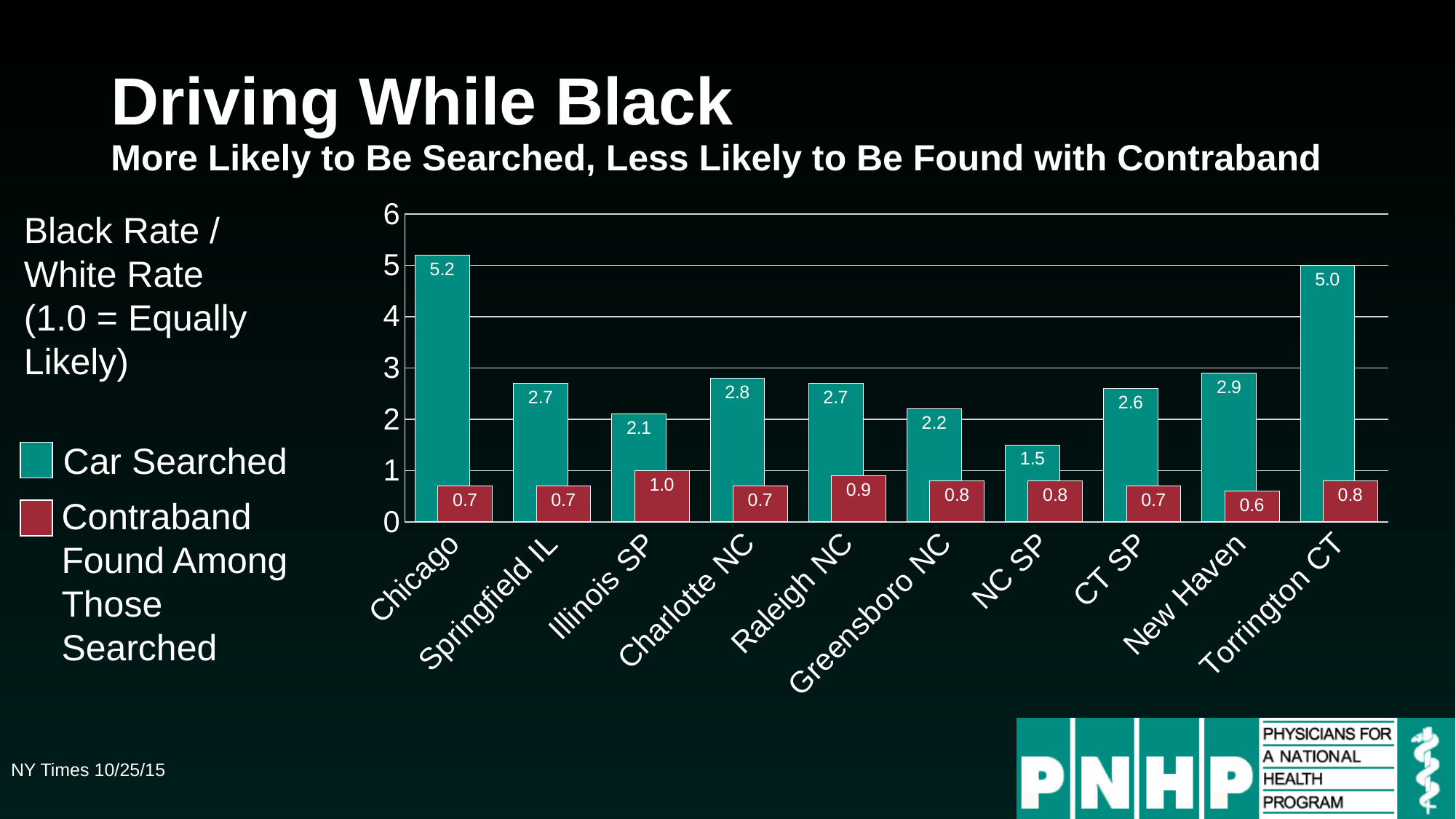
What is the Contraband Found Among Those Searched value for Illinois SP? 1.0 Which location has the lowest Contraband Found Among Those Searched value? New Haven Which location has the highest Car Searched value? Chicago What is the Car Searched value for New Haven? 2.9 Which location has the lowest Car Searched value? NC SP Which is larger, the Car Searched value for Charlotte NC or for Raleigh NC? Charlotte NC What is the difference between the Car Searched value and the Contraband Found value for Torrington CT? 4.2 How many series does the legend list? 2 How many locations are shown on the x axis? 10 What is the Car Searched value for Chicago? 5.2 What kind of chart is shown on the slide? bar chart Is the Car Searched value for Greensboro NC greater or less than 3? less